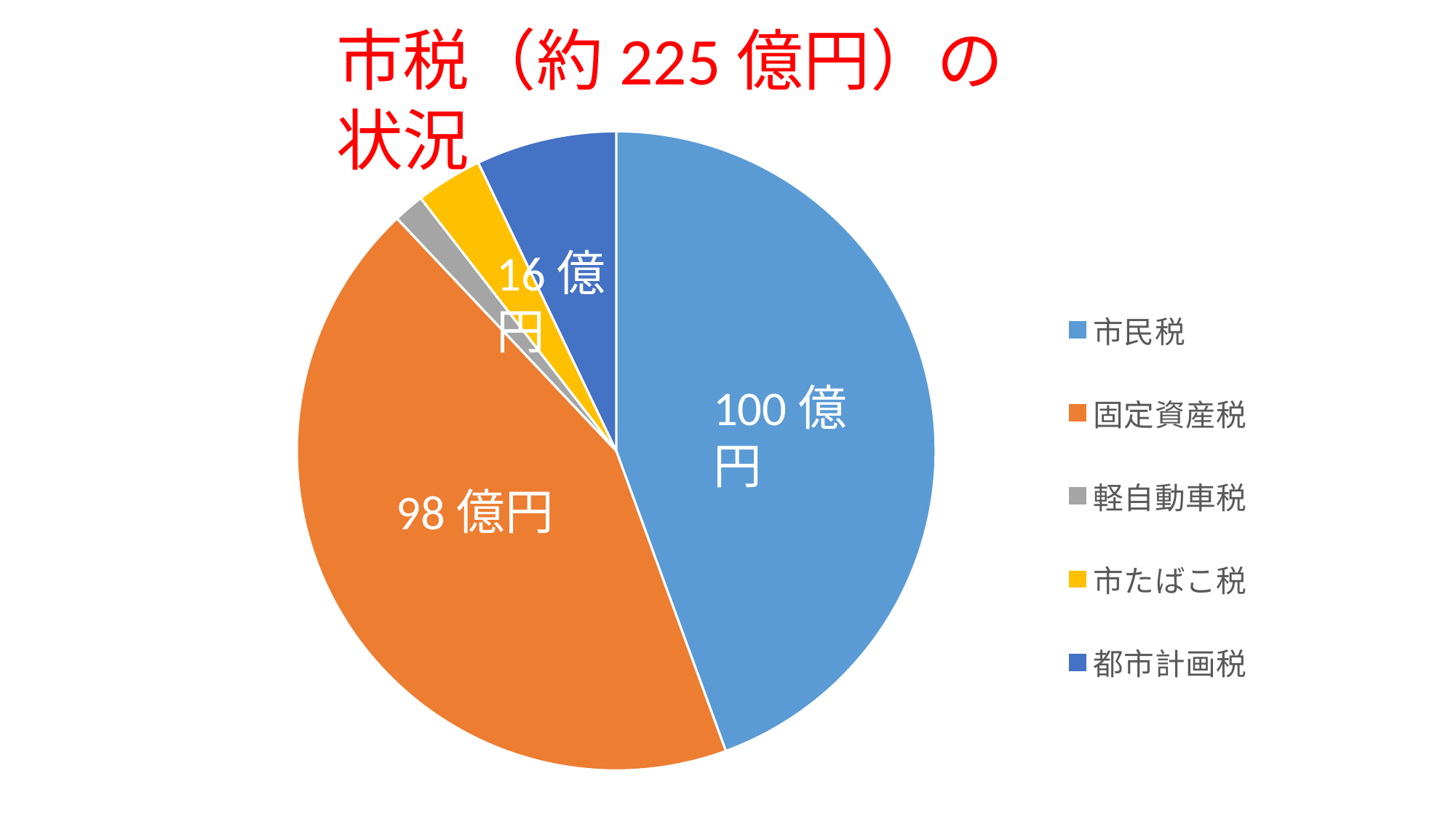
How many categories does the pie chart show? 5 What kind of chart is shown on the slide? Pie chart What value is shown for 固定資産税 in the pie chart? 98億円 What is the difference between the values for 市民税 and 固定資産税? 2億円 What value is shown for 市民税 in the pie chart? 100億円 Which category has the largest slice in the pie chart? 市民税 Which category has the smallest slice in the pie chart? 軽自動車税 Which category is shown in yellow in the legend? 市たばこ税 What is the difference between the values for 市民税 and 都市計画税? 84億円 Which is larger, the value for 固定資産税 or the value for 都市計画税? 固定資産税 What is the title of the chart? 市税（約225億円）の状況 What value is shown for 都市計画税 in the pie chart? 16億円